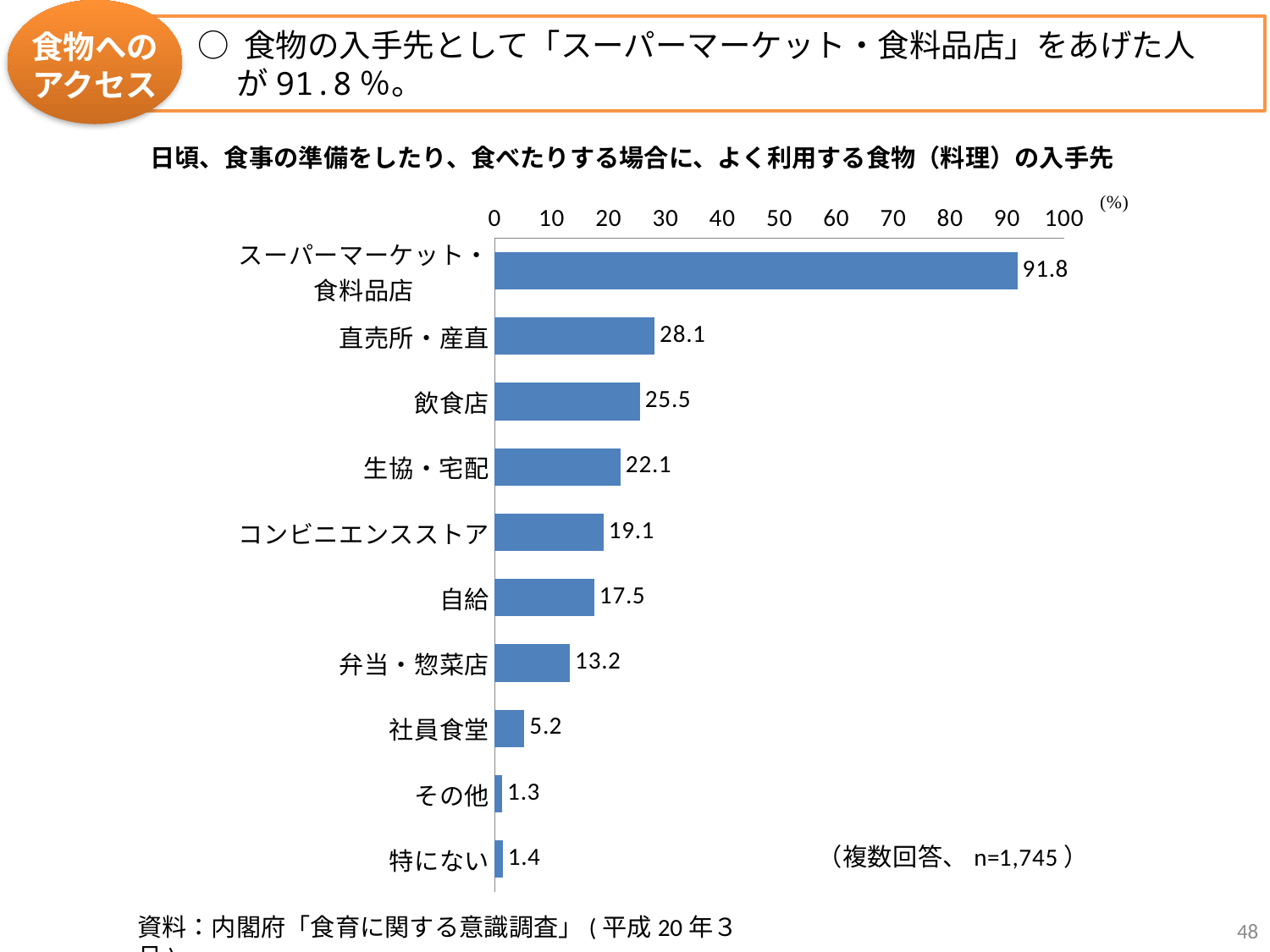
What is the value for コンビニエンスストア? 19.1 What is the value for 直売所・産直? 28.1 What is the value for スーパーマーケット・食料品店? 91.8 Which category has the lowest value? その他 What is the difference between the values for 直売所・産直 and 飲食店? 2.6 Which is larger, the value for 生協・宅配 or the value for 自給? 生協・宅配 What is the value for 社員食堂? 5.2 What is the sample size (n) noted on the chart? n=1,745 Is the value for 弁当・惣菜店 greater or less than 20? less How many categories are shown in the chart? 10 What kind of chart is shown on the slide? bar chart Which category has the highest value? スーパーマーケット・食料品店